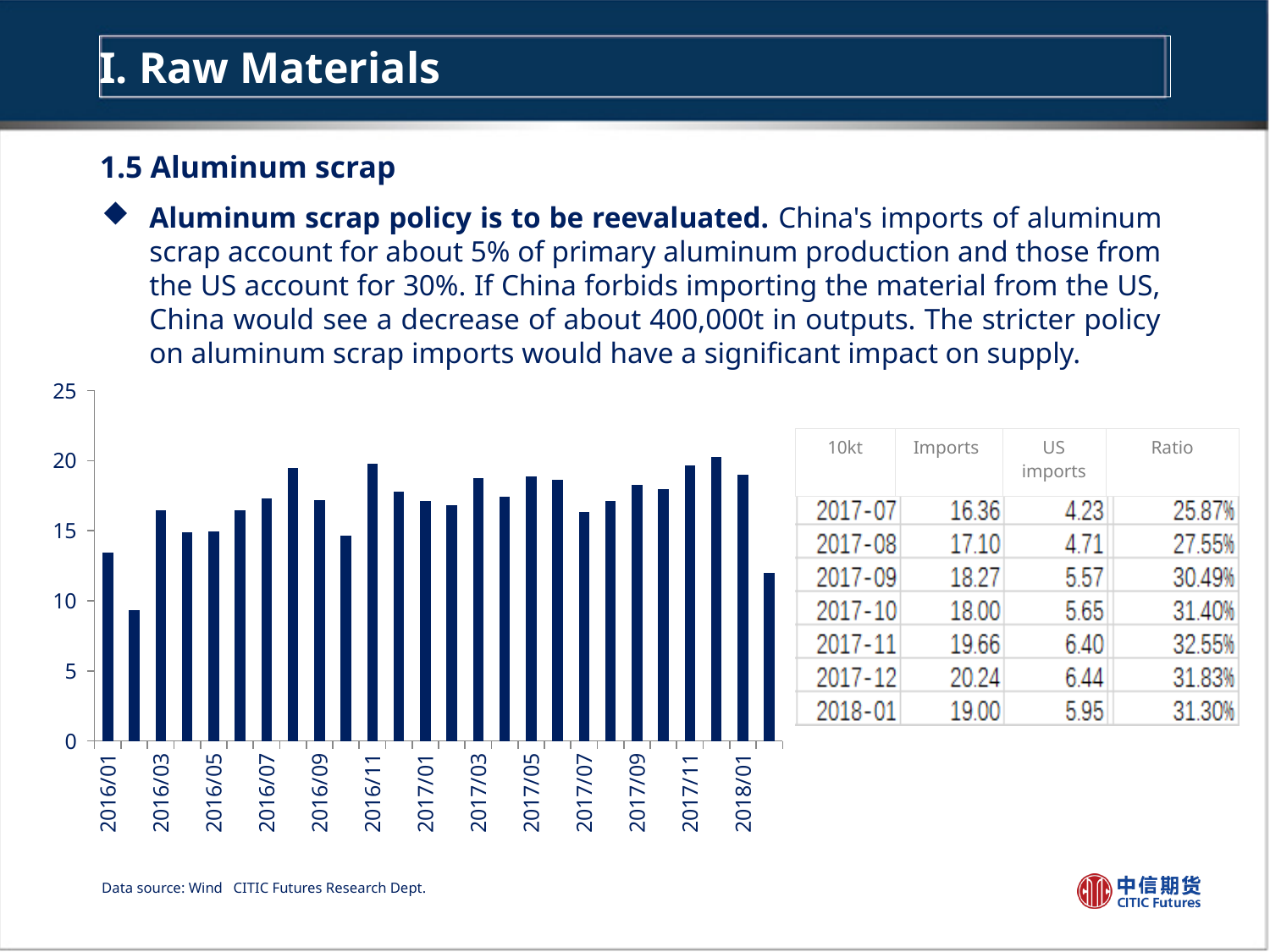
Is the value for 2016/02 greater or less than 10? less Which month has the lowest bar in the chart? 2016/02 According to the table next to the chart, what is the Ratio for 2017-11? 32.55% Which month has the highest bar in the chart? 2017/12 Is the value for 2018/02 greater or less than 10? greater What kind of chart is shown on the slide? bar chart What is the highest value shown on the chart's y axis? 25 Is the value for 2016/01 greater or less than 15? less According to the table next to the chart, what is the Imports value for 2017-12? 20.24 Which is larger, the bar for 2018/01 or the bar for 2018/02? 2018/01 Which is larger, the bar for 2016/01 or the bar for 2016/02? 2016/01